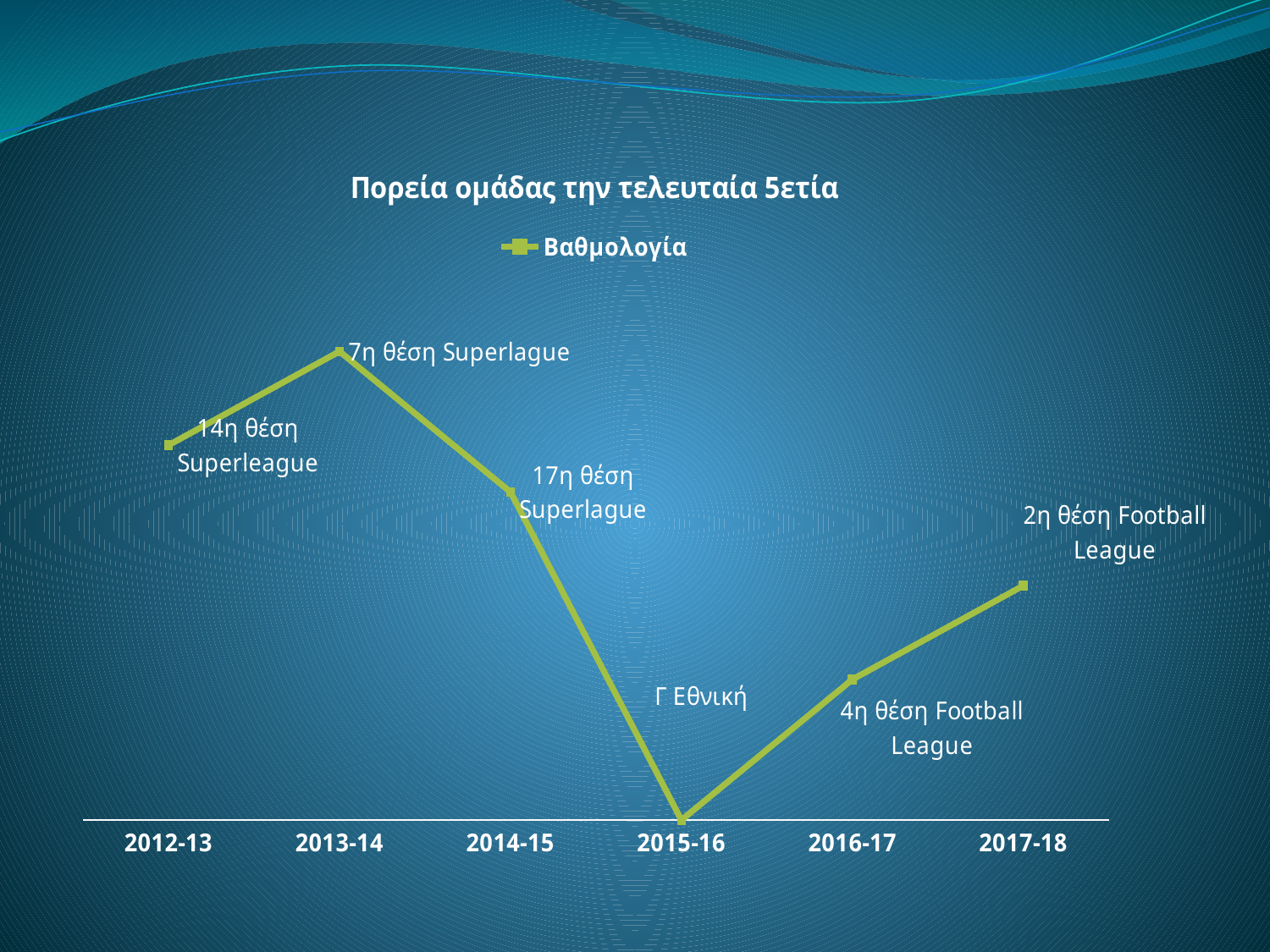
Which season has the lowest point on the line? 2015-16 What is the data label for 2014-15? 17η θέση Superlague Does the line rise or fall from 2015-16 to 2017-18? rise How many series does the legend list? 1 What is the data label for 2015-16? Γ Εθνική What is the data label for 2017-18? 2η θέση Football League What is the data label for 2013-14? 7η θέση Superlague Which season has the highest point on the line? 2013-14 What is the data label for 2012-13? 14η θέση Superleague How many seasons are plotted on the x axis? 6 What kind of chart is shown? line chart What is the data label for 2016-17? 4η θέση Football League